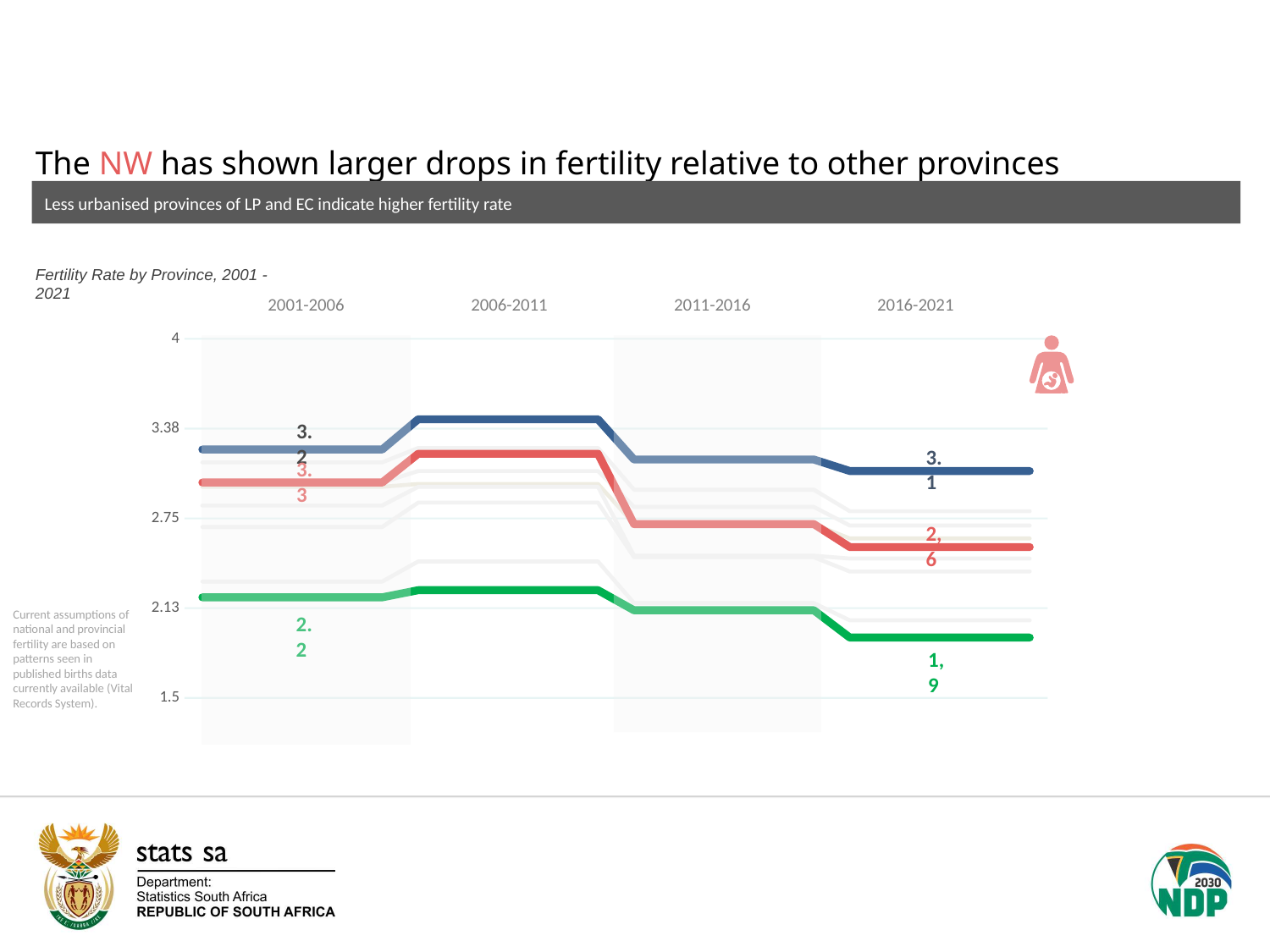
What is the value of the red line for 2016-2021? 2,6 By how much did the green line fall from 2001-2006 to 2016-2021? 0.3 What kind of chart is shown on the slide? line chart Is the value of the dark blue line in 2006-2011 greater or less than 3.38? greater What is the value of the green line for 2001-2006? 2.2 How many time periods are shown along the x axis of the chart? 4 In 2016-2021, which is higher, the dark blue line or the red line? dark blue line What is the value of the green line for 2016-2021? 1,9 What is the value of the dark blue line for 2016-2021? 3.1 What is the title of the chart? Fertility Rate by Province, 2001 - 2021 Does the green line rise or fall from 2001-2006 to 2016-2021? fall